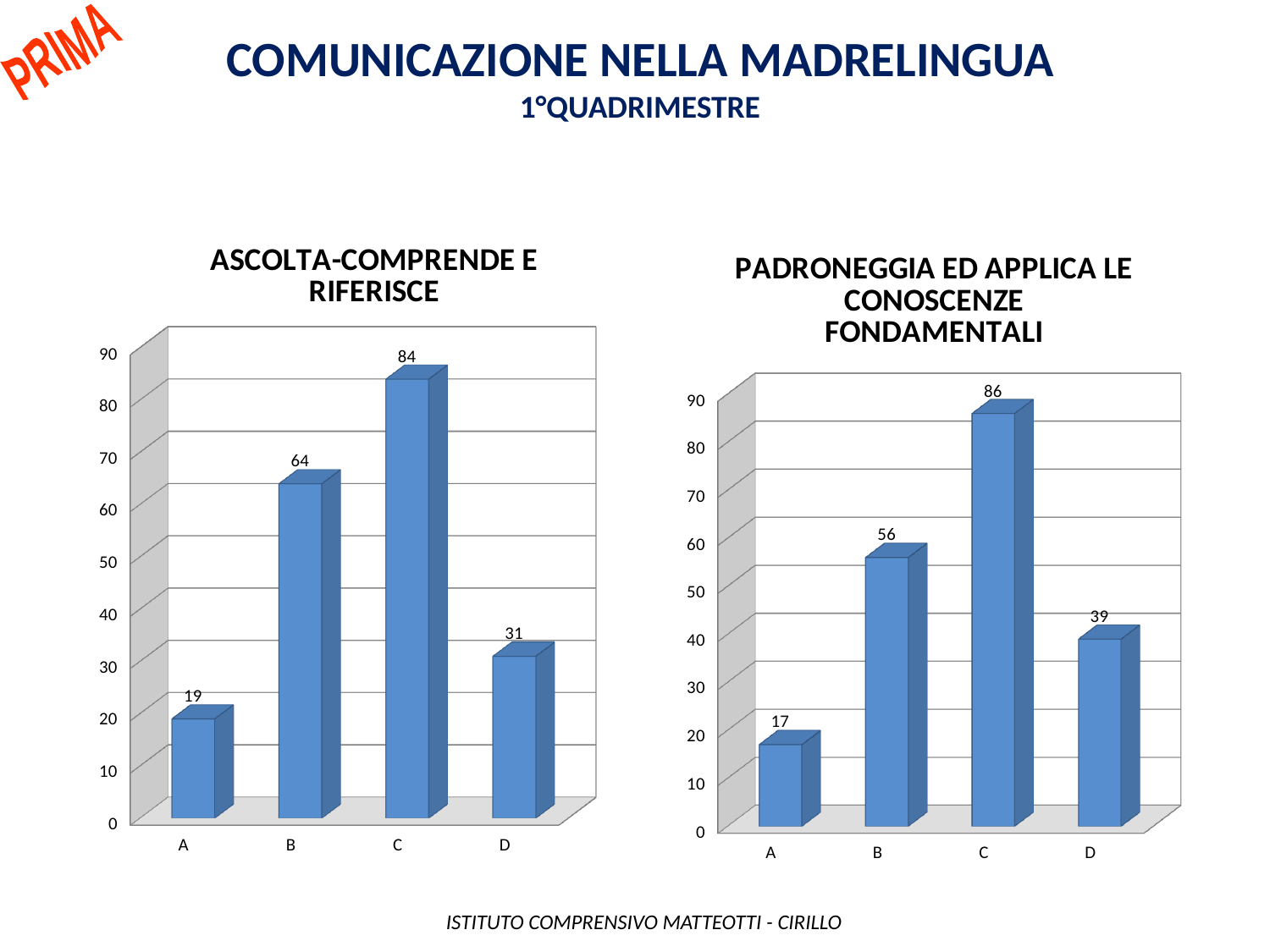
In the 'ASCOLTA-COMPRENDE E RIFERISCE' chart, which is larger, the value for B or the value for D? B In the 'ASCOLTA-COMPRENDE E RIFERISCE' chart, which category has the lowest value? A In the 'PADRONEGGIA ED APPLICA LE CONOSCENZE FONDAMENTALI' chart, what is the value for category A? 17 What kind of chart is the 'PADRONEGGIA ED APPLICA LE CONOSCENZE FONDAMENTALI' chart? Bar chart What is the main title of the slide? COMUNICAZIONE NELLA MADRELINGUA In the 'ASCOLTA-COMPRENDE E RIFERISCE' chart, what is the value for category C? 84 In the 'ASCOLTA-COMPRENDE E RIFERISCE' chart, what is the difference between the values for C and B? 20 In the 'PADRONEGGIA ED APPLICA LE CONOSCENZE FONDAMENTALI' chart, is the value for D greater or less than 30? greater In the 'PADRONEGGIA ED APPLICA LE CONOSCENZE FONDAMENTALI' chart, which category has the highest value? C How many categories are shown in the 'ASCOLTA-COMPRENDE E RIFERISCE' chart? 4 In the 'ASCOLTA-COMPRENDE E RIFERISCE' chart, what is the value for category D? 31 In the 'PADRONEGGIA ED APPLICA LE CONOSCENZE FONDAMENTALI' chart, what is the difference between the values for B and D? 17